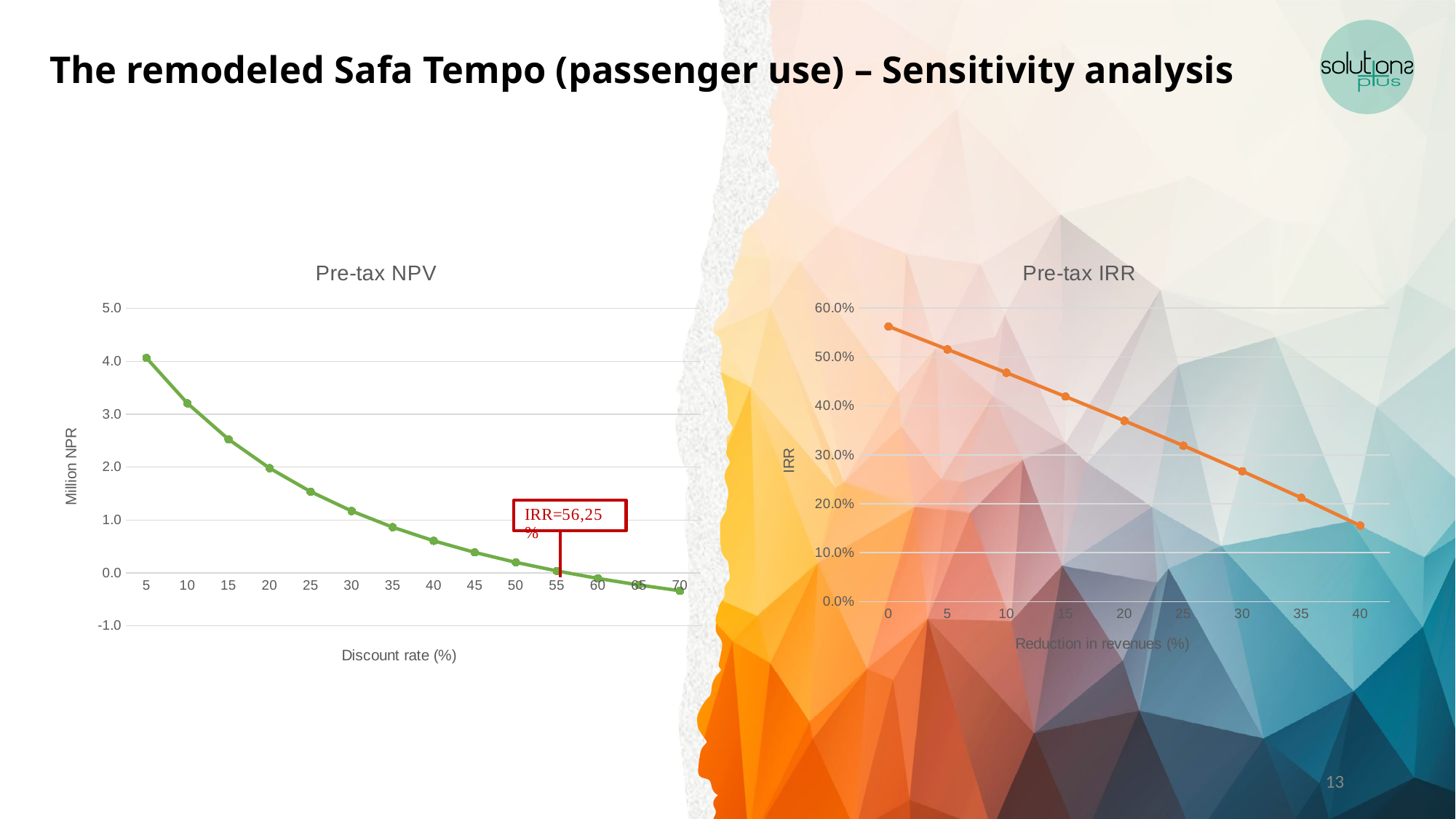
In the Pre-tax NPV chart, is the value at a discount rate of 70 greater or less than 0.0? less In the Pre-tax IRR chart, is the value at a 0% reduction in revenues greater or less than 50.0%? greater In the Pre-tax IRR chart, is the value at a 40% reduction in revenues greater or less than 20.0%? less What kind of chart is the Pre-tax NPV chart? line chart What is the x-axis label of the Pre-tax IRR chart? Reduction in revenues (%) In the Pre-tax NPV chart, which discount rate gives the highest NPV? 5 In the Pre-tax IRR chart, do the values rise or fall as the reduction in revenues increases? fall How many data points are plotted in the Pre-tax IRR chart? 9 How many data points are plotted in the Pre-tax NPV chart? 14 In the Pre-tax NPV chart, do the values rise or fall as the discount rate increases? fall